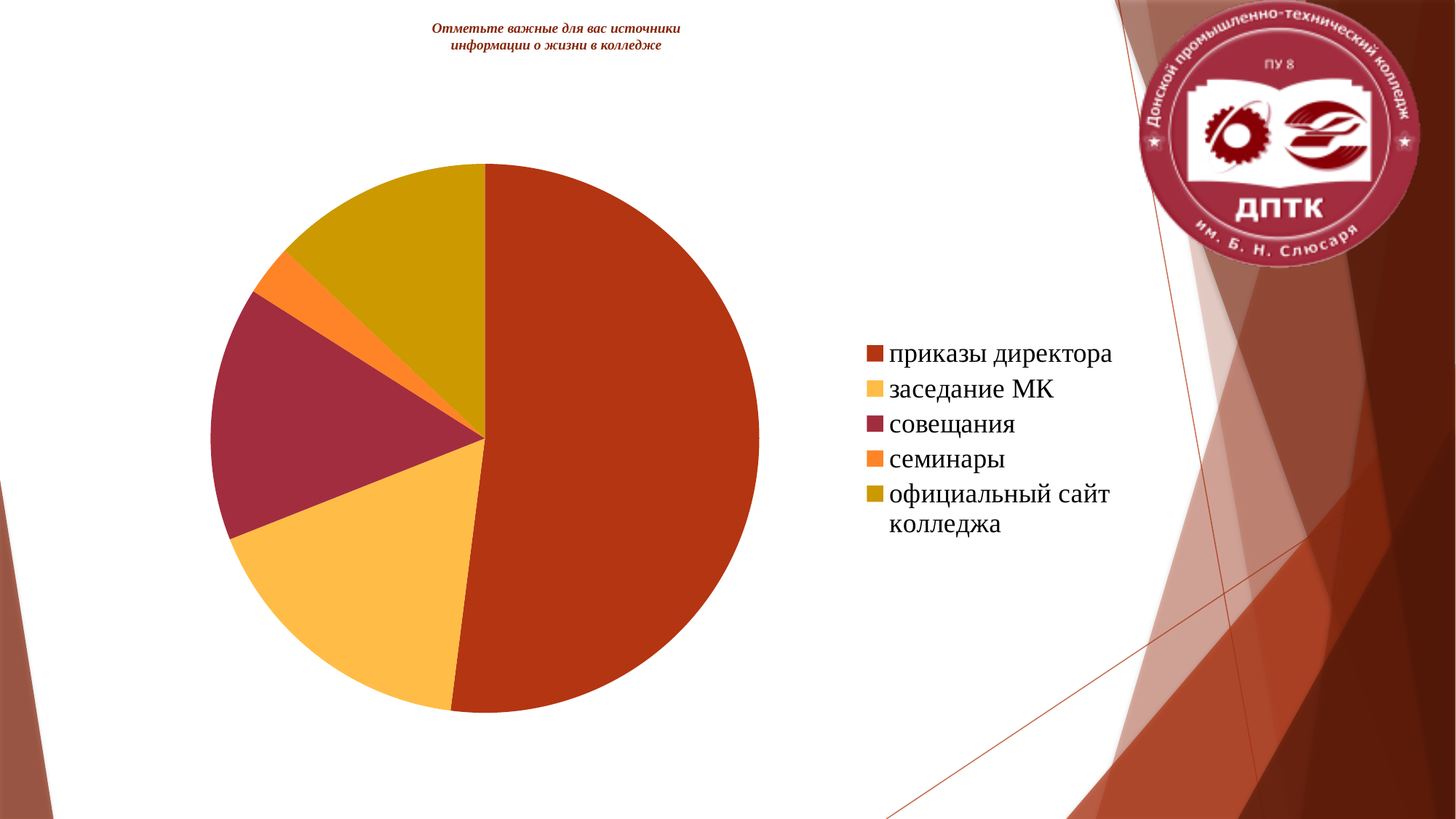
Which slice is larger: совещания or семинары? совещания Which category has the smallest slice in the pie chart? семинары Which slice is larger: официальный сайт колледжа or семинары? официальный сайт колледжа What kind of chart is shown on the slide? pie chart Which category has the largest slice in the pie chart? приказы директора Which slice is larger: приказы директора or заседание МК? приказы директора How many slices does the pie chart have? 5 What is the title of the chart on the slide? Отметьте важные для вас источники информации о жизни в колледже Which legend entry is shown in the gold/dark yellow colour? официальный сайт колледжа